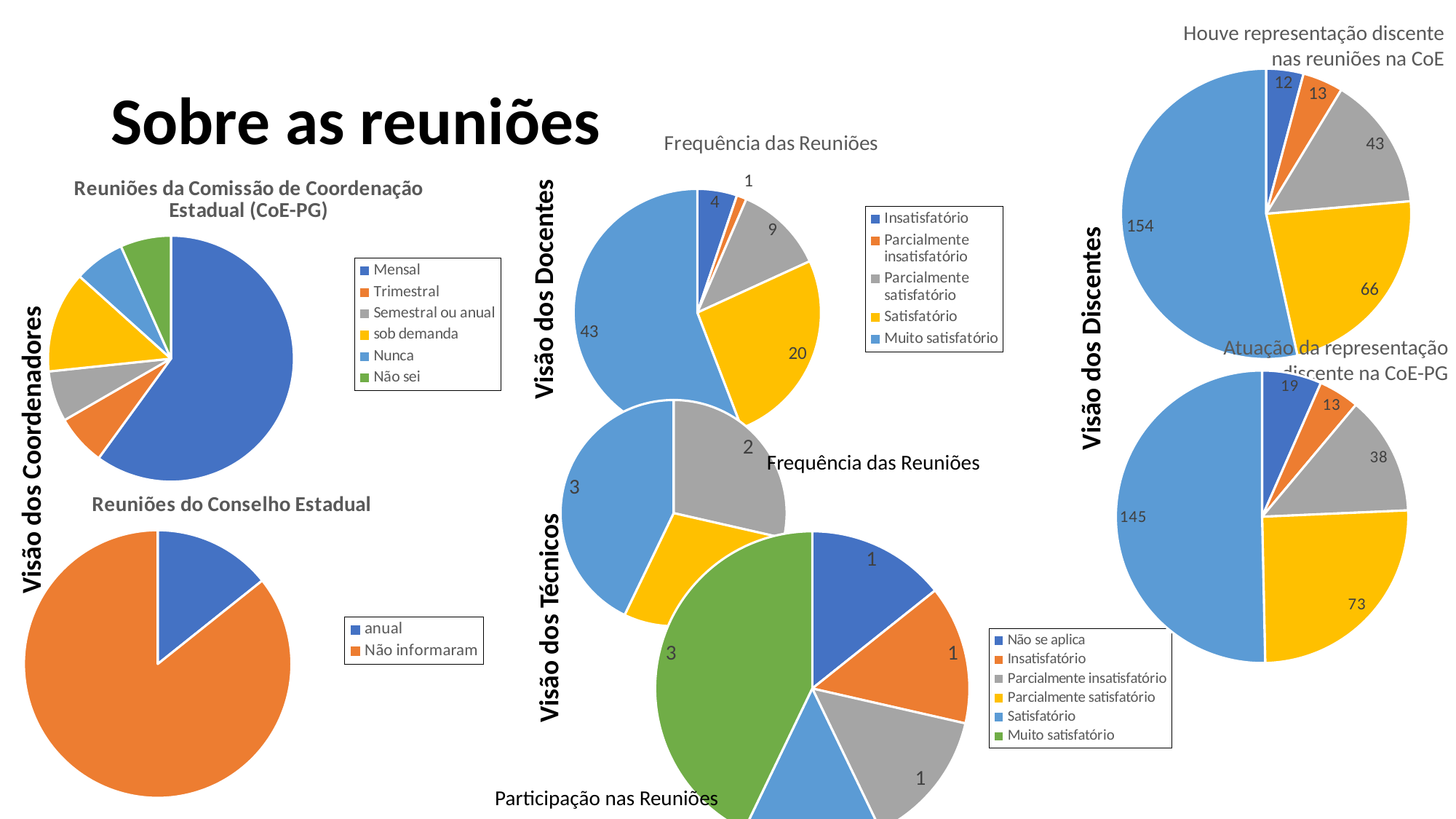
In the 'Atuação da representação discente na CoE-PG' pie chart, which is larger: the value 73 slice or the value 38 slice? 73 In the 'Reuniões do Conselho Estadual' pie chart, which category has the largest slice? Não informaram In the 'Frequência das Reuniões' pie chart under 'Visão dos Docentes', which category has the smallest slice? Parcialmente insatisfatório In the 'Frequência das Reuniões' pie chart under 'Visão dos Docentes', what is the value for Satisfatório? 20 In the 'Frequência das Reuniões' pie chart under 'Visão dos Docentes', what is the value for Muito satisfatório? 43 How many entries does the legend of the 'Frequência das Reuniões' chart under 'Visão dos Docentes' list? 5 In the 'Atuação da representação discente na CoE-PG' pie chart, what is the largest value shown? 145 In the 'Frequência das Reuniões' pie chart under 'Visão dos Docentes', what is the value for Parcialmente satisfatório? 9 In the 'Houve representação discente nas reuniões na CoE' pie chart, what is the largest value shown? 154 In the 'Frequência das Reuniões' pie chart under 'Visão dos Docentes', what is the difference between the Muito satisfatório and Satisfatório values? 23 In the 'Houve representação discente nas reuniões na CoE' pie chart, what is the smallest value shown? 12 What type of chart is 'Reuniões da Comissão de Coordenação Estadual (CoE-PG)'? Pie chart